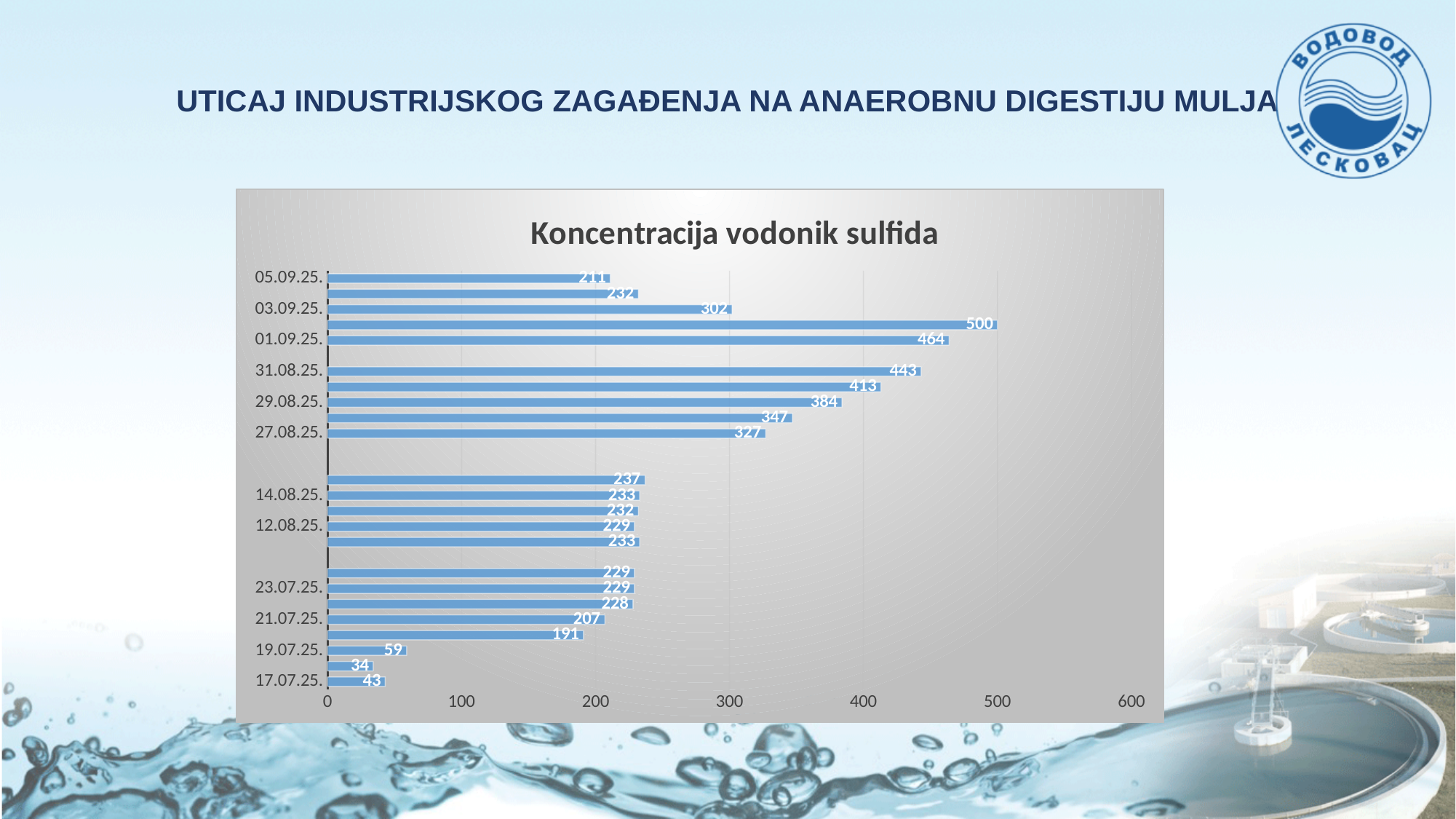
How many bars are plotted on the chart? 23 What is the value for 05.09.25.? 211 What type of chart is shown on the slide? bar chart What is the title of the chart? Koncentracija vodonik sulfida What is the value for 17.07.25.? 43 What is the value for 01.09.25.? 464 What is the difference between the values for 31.08.25. and 29.08.25.? 59 What is the lowest value shown on the chart? 34 Which is larger, the value for 03.09.25. or the value for 21.07.25.? 03.09.25. Is the value for 19.07.25. greater or less than 100? less What is the highest value shown on the chart? 500 What is the value for 27.08.25.? 327